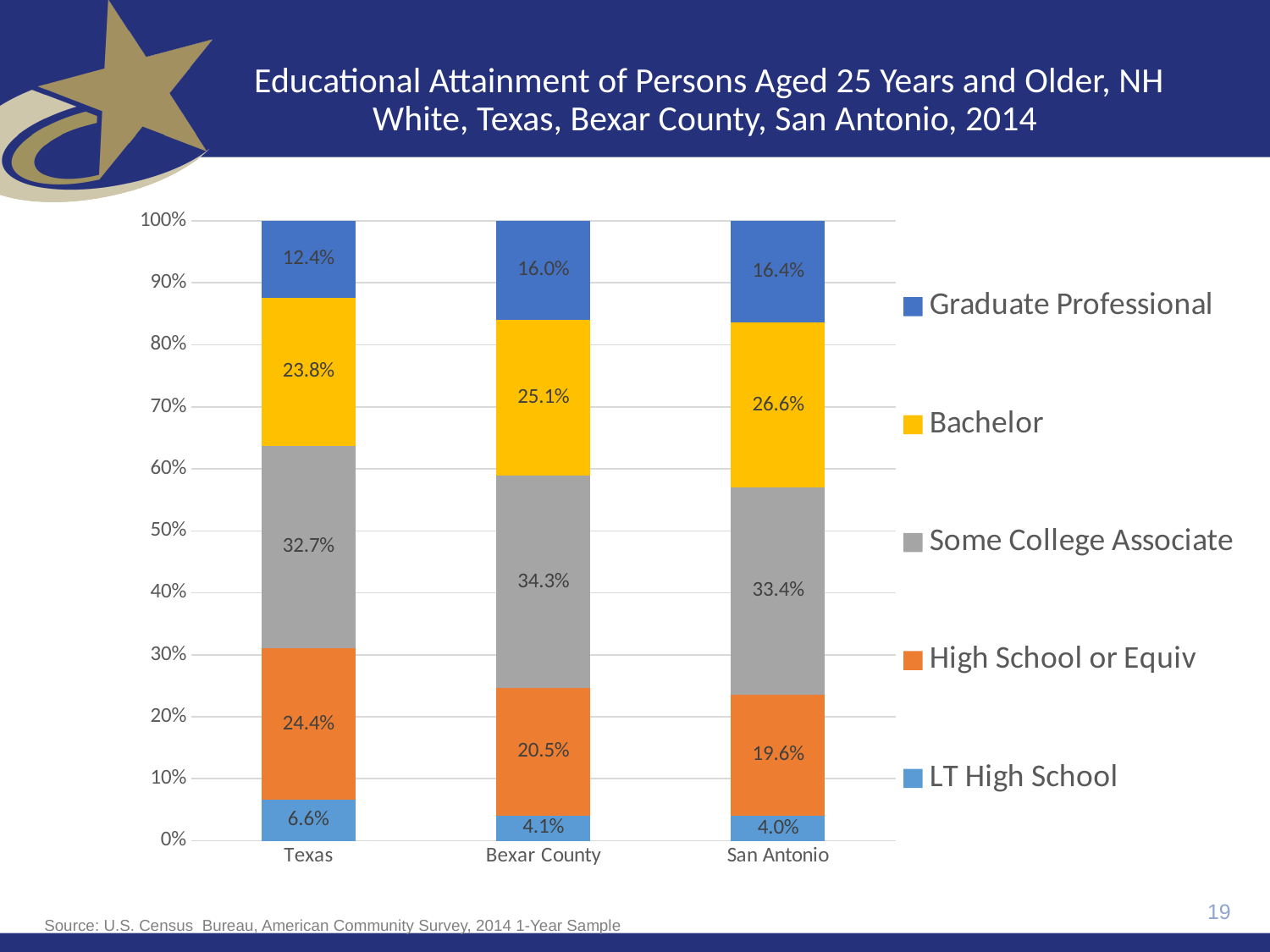
Which category has the lowest Graduate Professional value? Texas What is the Graduate Professional value for Bexar County? 16.0% What is the difference between the Bachelor values for San Antonio and Texas? 2.8% What is the Bachelor value for San Antonio? 26.6% Which series is shown in yellow in the legend? Bachelor What is the Some College Associate value for Bexar County? 34.3% What kind of chart is shown on the slide? Stacked bar chart Which is larger, the High School or Equiv value for Bexar County or for San Antonio? Bexar County How many categories are shown on the x axis? 3 Which category has the highest High School or Equiv value? Texas What is the LT High School value for Texas? 6.6% How many series does the legend list? 5